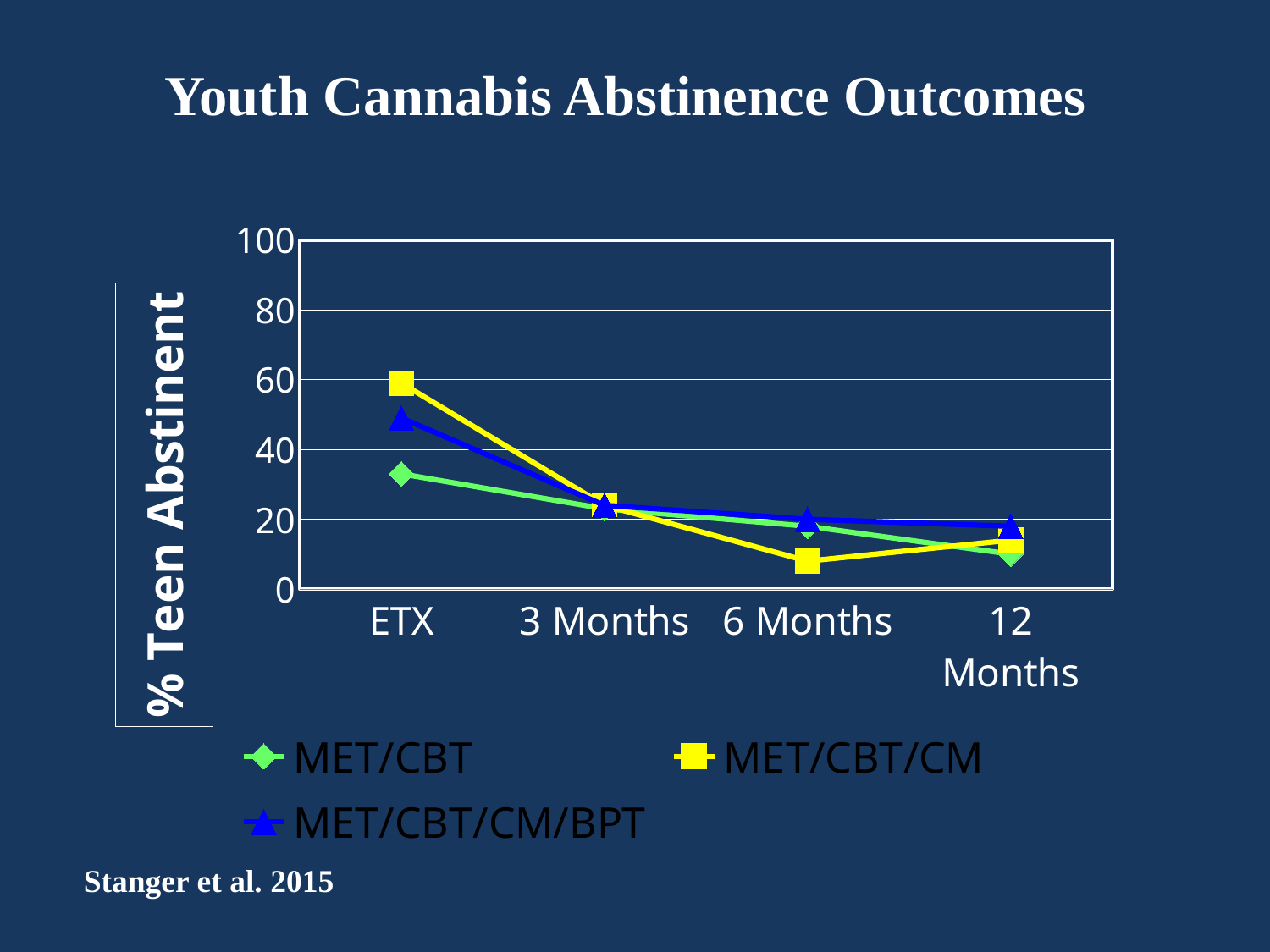
What kind of chart is shown on the slide? Line chart Does the MET/CBT series rise or fall from ETX to 12 Months? Fall Which series has the lowest value at 6 Months? MET/CBT/CM At ETX, which is larger: the value for MET/CBT/CM/BPT or the value for MET/CBT? MET/CBT/CM/BPT How many series does the legend list? 3 Which series has the highest value at ETX? MET/CBT/CM Is the value for MET/CBT/CM at 6 Months greater or less than 20? less Is the value for MET/CBT at 12 Months greater or less than 20? less How many time points are plotted along the x axis? 4 What is the label on the y axis? % Teen Abstinent Which series has the lowest value at ETX? MET/CBT Is the value for MET/CBT/CM at ETX greater or less than 40? greater